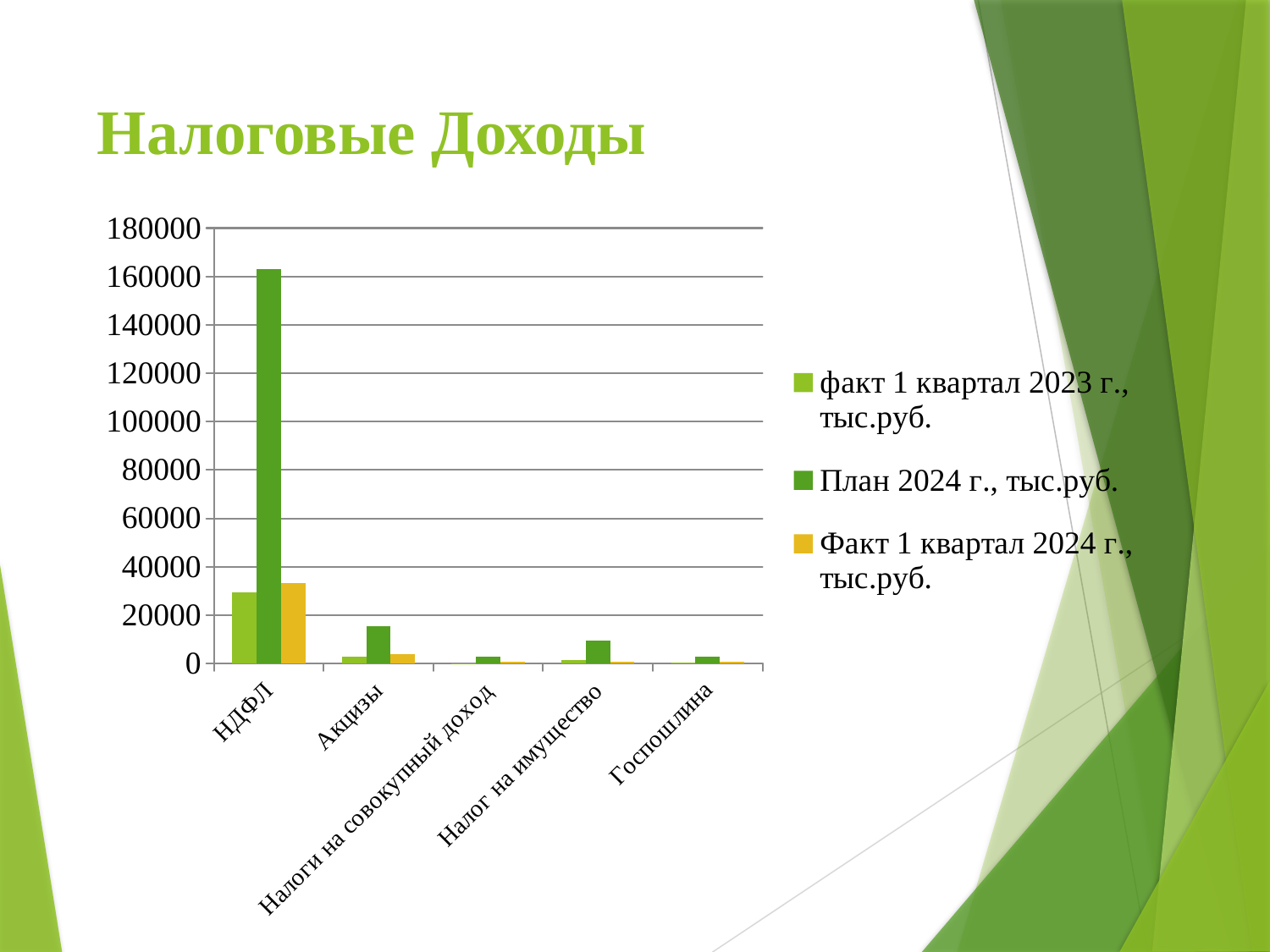
Which category has the highest value for the series 'Факт 1 квартал 2024 г., тыс.руб.'? НДФЛ For the series 'План 2024 г., тыс.руб.', which is larger: Акцизы or Налог на имущество? Акцизы How many series does the legend list? 3 Is the value of 'План 2024 г., тыс.руб.' for Акцизы greater or less than 20000? less For НДФЛ, which is larger: 'План 2024 г., тыс.руб.' or 'факт 1 квартал 2023 г., тыс.руб.'? План 2024 г., тыс.руб. How many categories are shown on the x axis of the chart? 5 Is the value of 'План 2024 г., тыс.руб.' for НДФЛ greater or less than 140000? greater What is the title of the slide's chart? Налоговые Доходы What kind of chart is shown on the slide? bar chart Which colour represents the series 'План 2024 г., тыс.руб.' in the legend? dark green Which category has the highest value for the series 'План 2024 г., тыс.руб.'? НДФЛ Is the value of 'Факт 1 квартал 2024 г., тыс.руб.' for НДФЛ greater or less than 40000? less